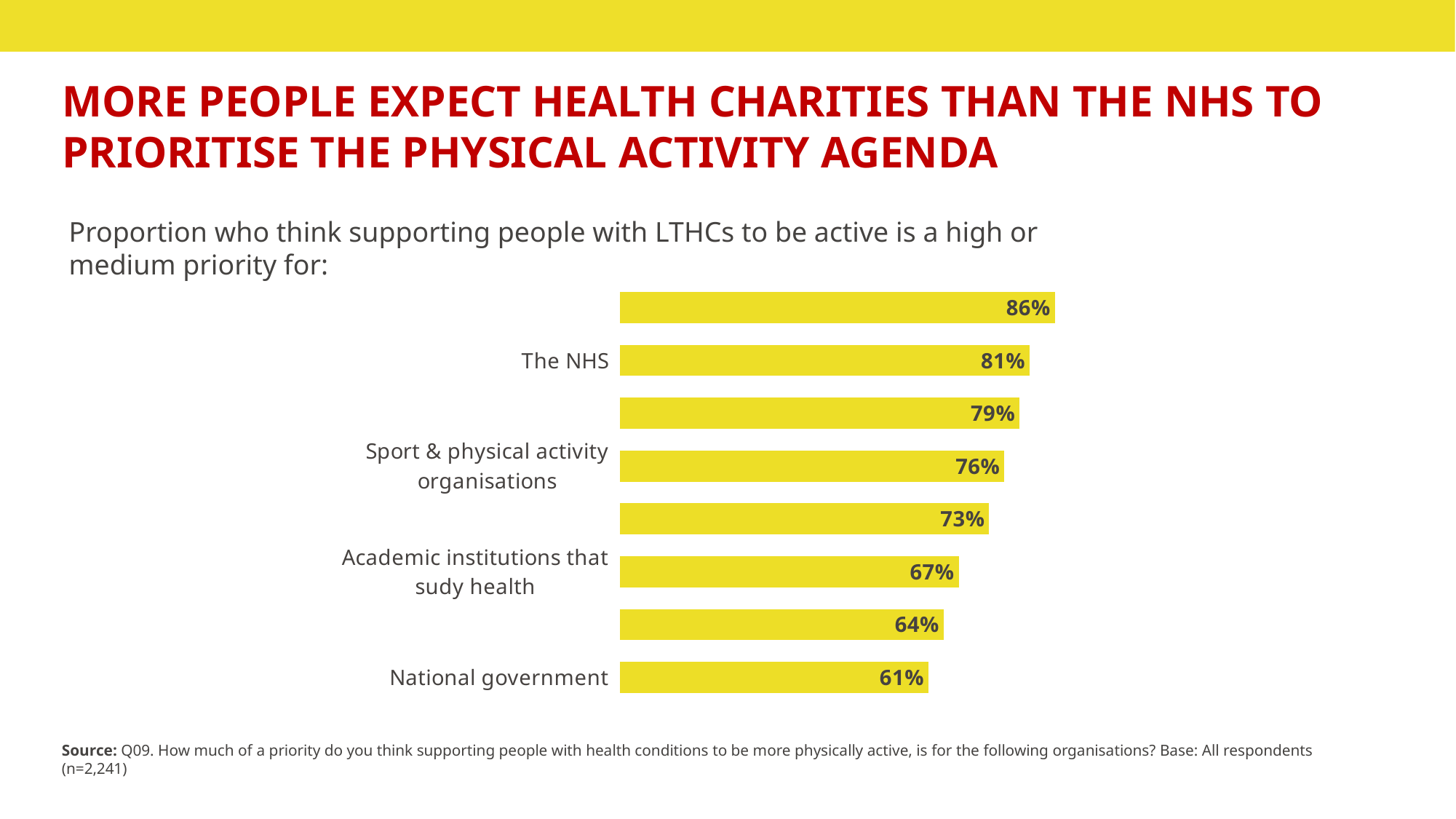
What is the difference between the values for The NHS and National government? 20% What kind of chart is shown on the slide? bar chart Which labelled category has the lowest value? National government What is the value for Academic institutions that sudy health? 67% What is the value for National government? 61% How many bars are plotted on the chart? 8 What is the highest value shown on the chart? 86% Which is larger, the value for The NHS or the value for Sport & physical activity organisations? The NHS What colour are the bars on the chart? yellow What is the value for The NHS? 81% What is the value for Sport & physical activity organisations? 76% What is the difference between the values for Sport & physical activity organisations and Academic institutions that sudy health? 9%